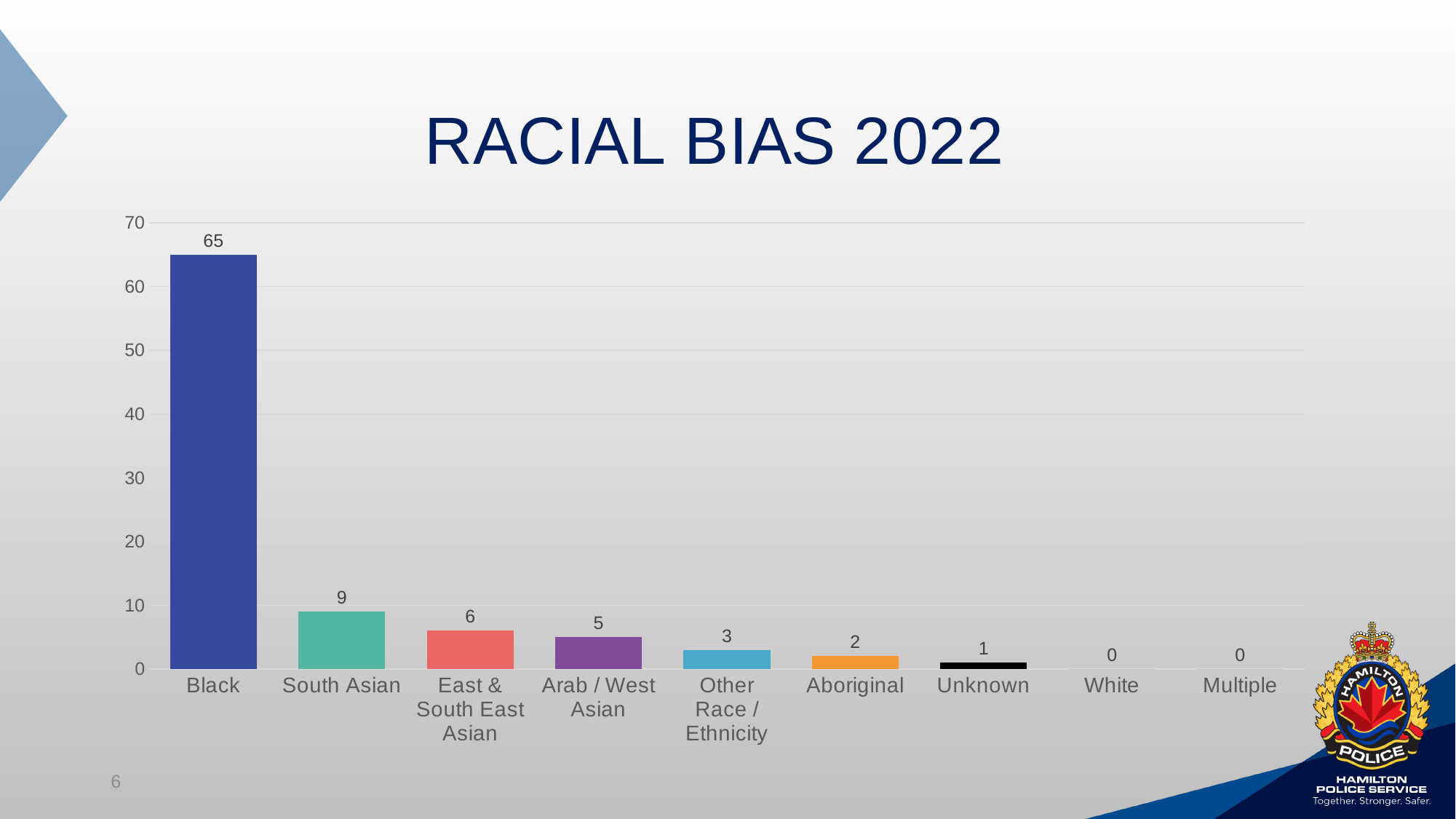
What is the value for Black? 65 What is the difference between the values for Black and South Asian? 56 What is the value for South Asian? 9 Which category has the highest value? Black Is the value for Black greater or less than 60? greater What is the title of the chart? RACIAL BIAS 2022 Which is larger, the value for Unknown or the value for Aboriginal? Aboriginal What is the value for Arab / West Asian? 5 What is the difference between the values for East & South East Asian and Other Race / Ethnicity? 3 What is the value for Aboriginal? 2 How many categories are shown on the x axis? 9 What kind of chart is shown on the slide? bar chart